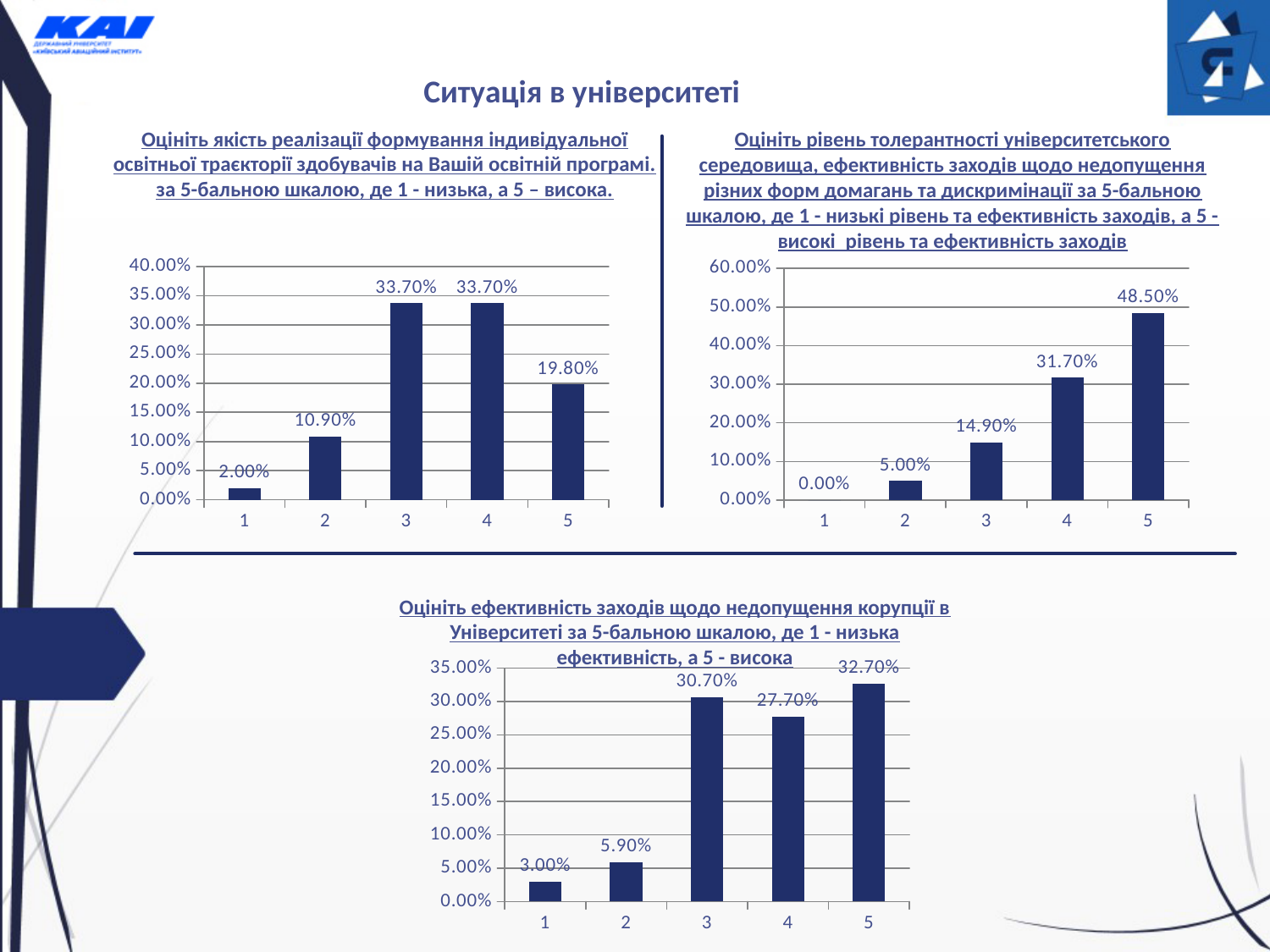
In the top-left chart, which category has the lowest value? 1 In the bottom chart, what is the value for category 2? 5.90% In the top-right chart, which category has the highest value? 5 In the bottom chart, which is larger, the value for category 3 or category 4? category 3 How many categories are shown on the x axis of the bottom chart? 5 In the top-left chart, what is the value for category 5? 19.80% In the top-right chart, what is the difference between the values for categories 5 and 4? 16.80% In the top-right chart, do the values rise or fall from category 1 to category 5? rise In the top-right chart, what is the value for category 4? 31.70% In the top-left chart, what is the difference between the values for categories 3 and 2? 22.80% In the bottom chart, which category has the highest value? 5 What kind of chart is the top-left chart? bar chart